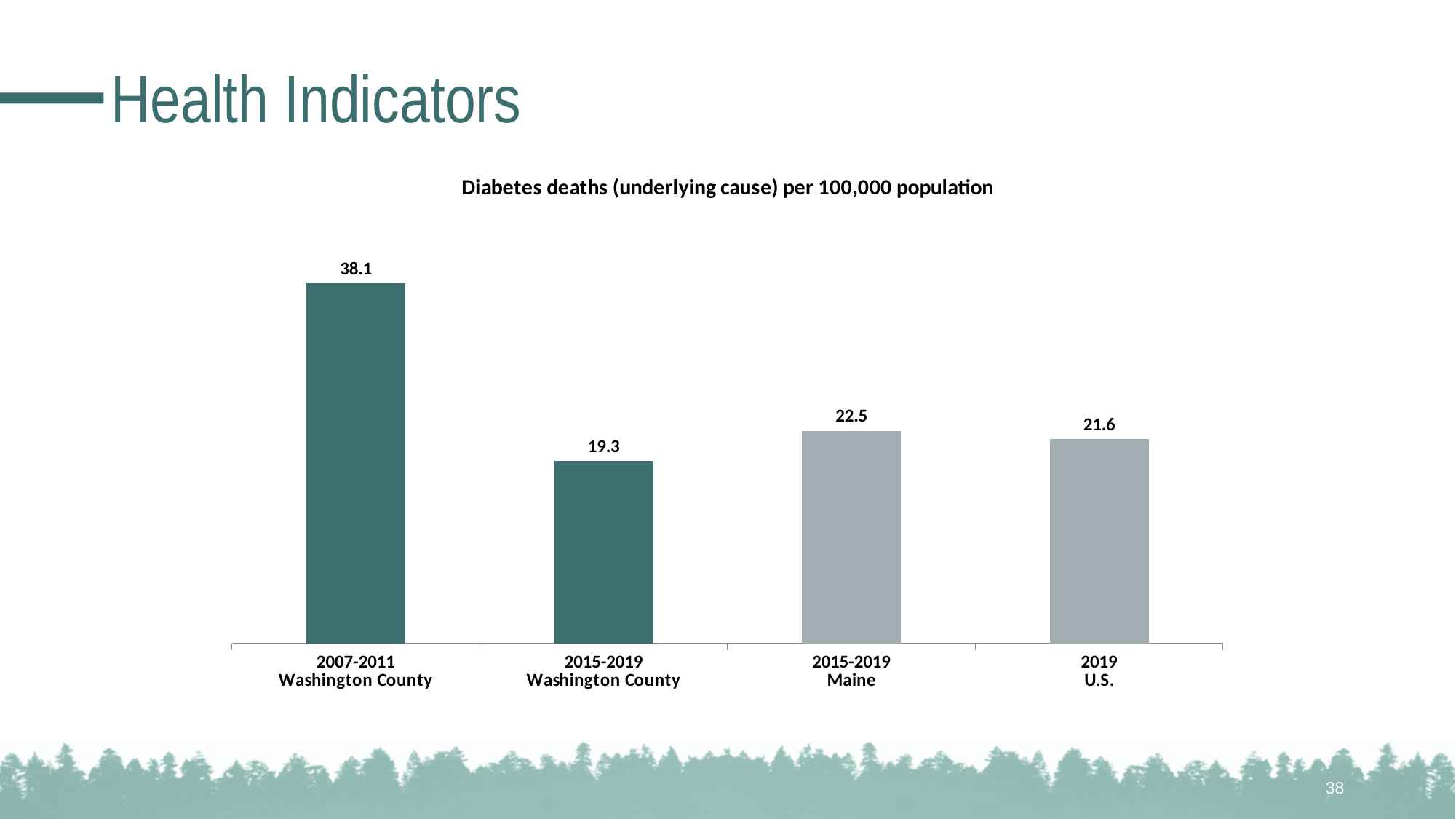
Which is larger, the 2015-2019 Maine rate or the 2019 U.S. rate? 2015-2019 Maine What is the diabetes death rate per 100,000 population for Washington County in 2007-2011? 38.1 How many bars are shown in the chart? 4 What is the diabetes death rate per 100,000 population for the U.S. in 2019? 21.6 What is the title of the chart? Diabetes deaths (underlying cause) per 100,000 population What is the diabetes death rate per 100,000 population for Maine in 2015-2019? 22.5 What type of chart is shown on the slide? Bar chart What is the difference between the 2015-2019 Maine rate and the 2015-2019 Washington County rate? 3.2 By how much did the diabetes death rate for Washington County fall from 2007-2011 to 2015-2019? 18.8 Which category has the highest diabetes death rate? 2007-2011 Washington County What is the diabetes death rate per 100,000 population for Washington County in 2015-2019? 19.3 Which category has the lowest diabetes death rate? 2015-2019 Washington County